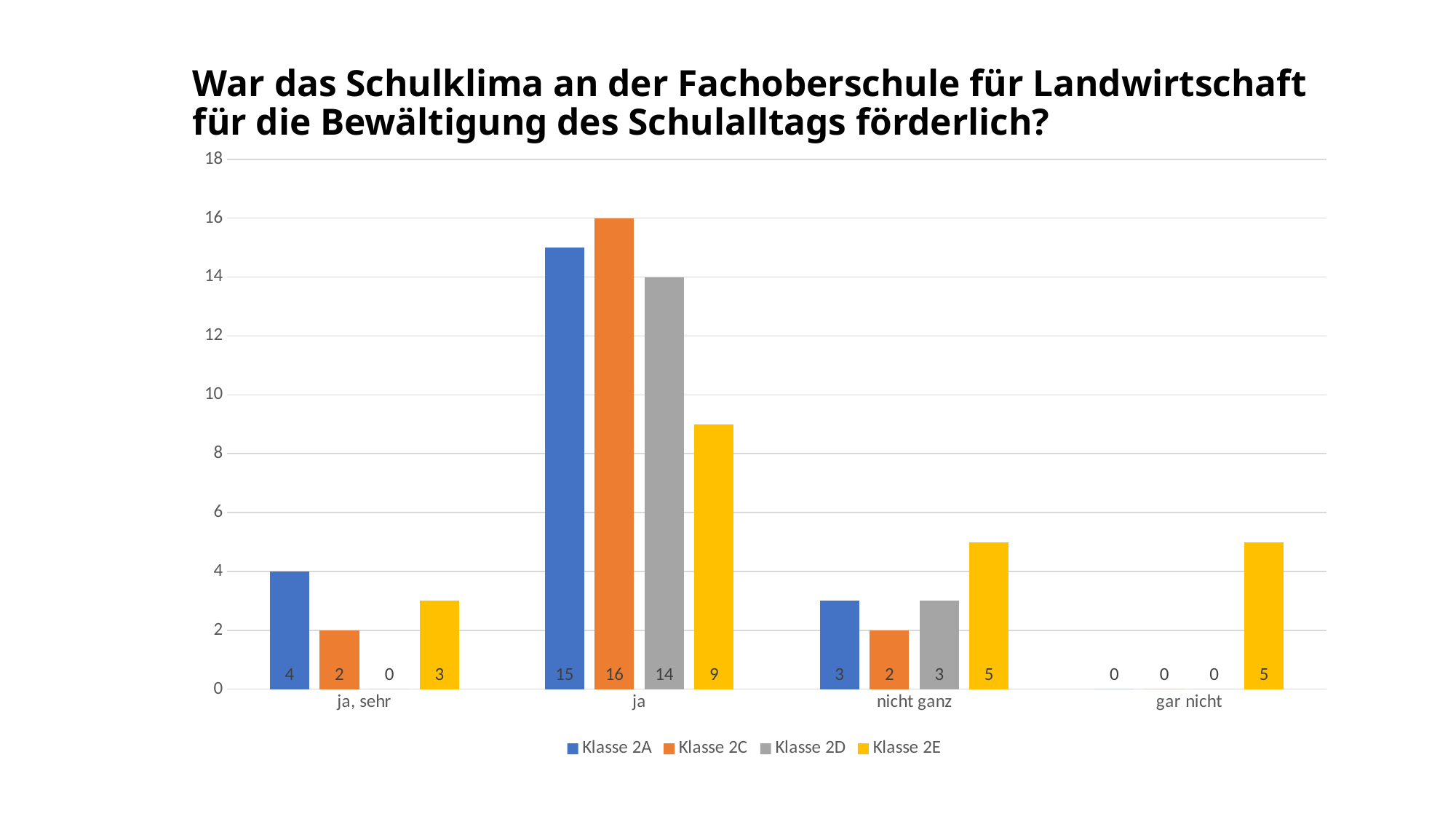
What is the value for Klasse 2D in the "ja, sehr" category? 0 Which is larger: Klasse 2A in "ja, sehr" or Klasse 2E in "ja, sehr"? Klasse 2A What is the value for Klasse 2C in the "ja" category? 16 What is the value for Klasse 2E in the "gar nicht" category? 5 Which colour represents Klasse 2E in the chart? yellow Is the value for Klasse 2D in the "ja" category greater or less than 10? greater What is the difference between Klasse 2A and Klasse 2E in the "ja" category? 6 How many categories are shown on the x axis? 4 Which class has the lowest value in the "ja" category? Klasse 2E What kind of chart is shown on the slide? bar chart Which class has the highest value in the "ja" category? Klasse 2C How many series does the legend list? 4